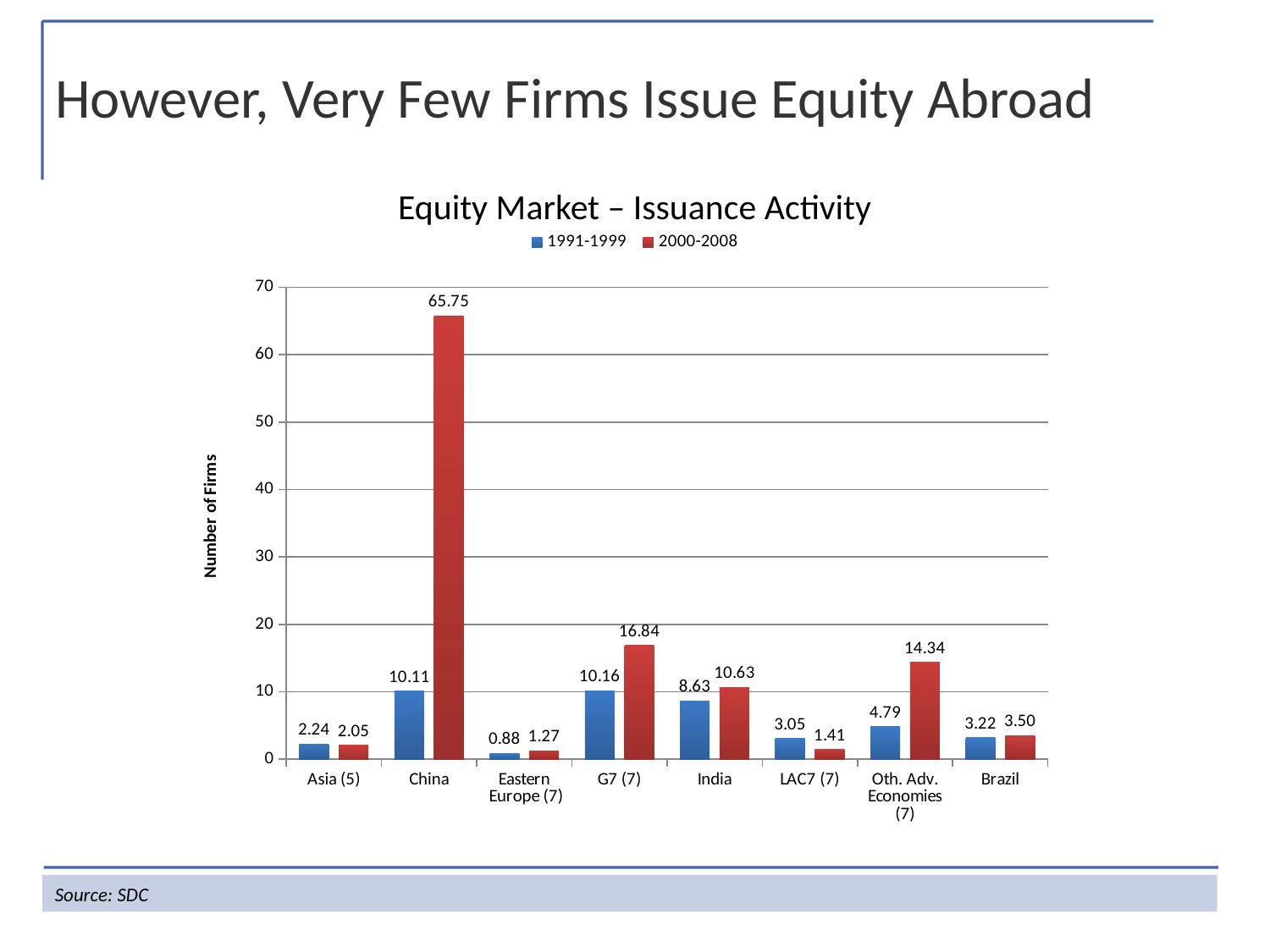
Which category has the highest value in the 2000-2008 series? China How many categories are shown on the x axis? 8 What is the value for G7 (7) in the 1991-1999 series? 10.16 Is the value for China in the 2000-2008 series greater or less than 60? greater Which category has the lowest value in the 1991-1999 series? Eastern Europe (7) Which is larger for LAC7 (7): the 1991-1999 value or the 2000-2008 value? 1991-1999 What is the value for China in the 2000-2008 series? 65.75 What kind of chart is shown on the slide? Bar chart What is the title of the chart? Equity Market – Issuance Activity What is the value for Oth. Adv. Economies (7) in the 2000-2008 series? 14.34 What is the difference between the 2000-2008 and 1991-1999 values for India? 2.00 How many series does the legend list? 2